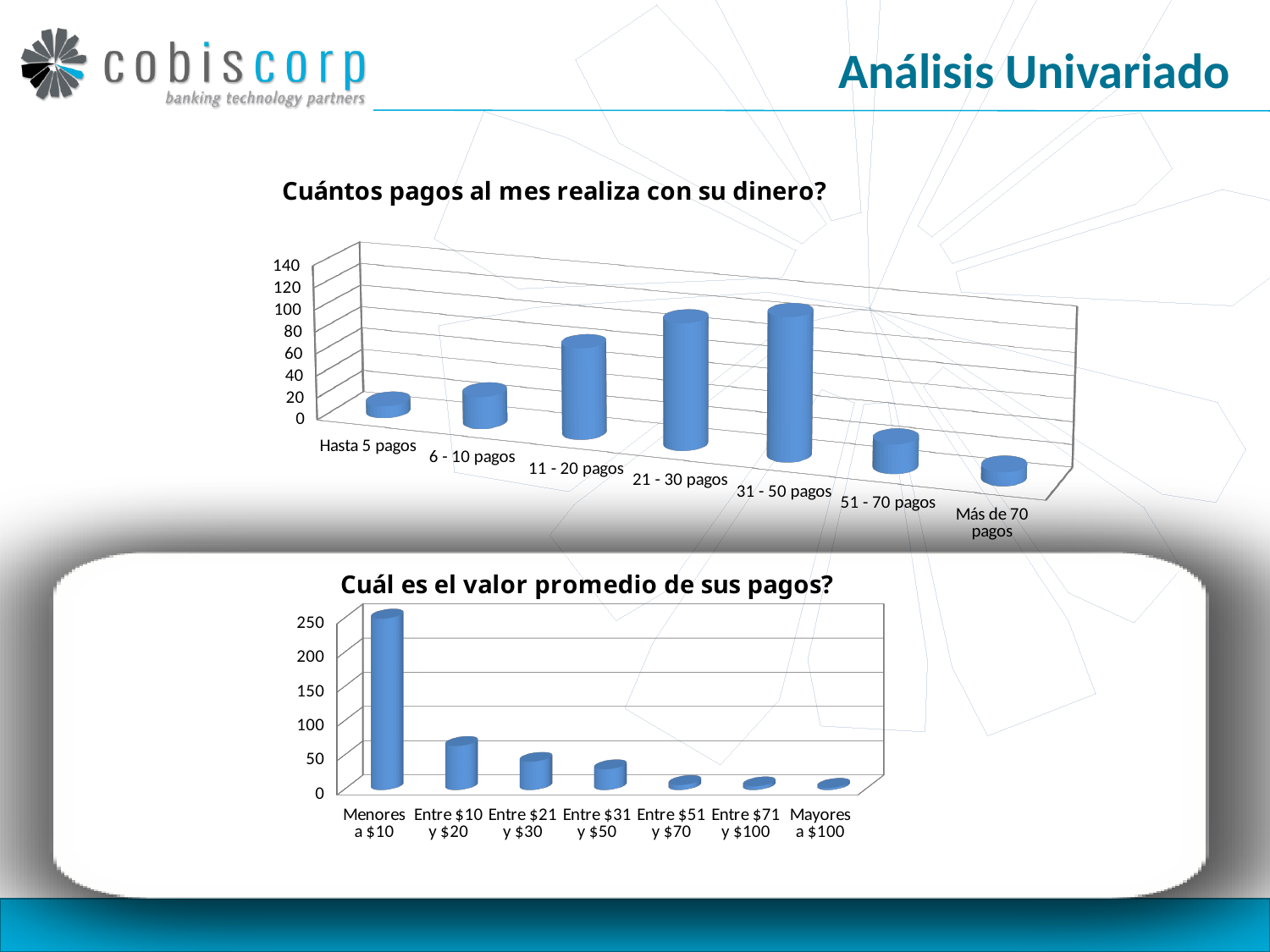
In the bottom chart 'Cuál es el valor promedio de sus pagos?', is the value for 'Menores a $10' greater or less than 200? greater In the top chart 'Cuántos pagos al mes realiza con su dinero?', is the value for 'Hasta 5 pagos' greater or less than 40? less In the top chart 'Cuántos pagos al mes realiza con su dinero?', which category has the highest value? 31 - 50 pagos What type of chart is the top chart titled 'Cuántos pagos al mes realiza con su dinero?'? bar chart In the top chart 'Cuántos pagos al mes realiza con su dinero?', how many categories are shown? 7 In the bottom chart 'Cuál es el valor promedio de sus pagos?', which category has the highest value? Menores a $10 In the bottom chart 'Cuál es el valor promedio de sus pagos?', is the value for 'Entre $10 y $20' greater or less than 100? less In the top chart 'Cuántos pagos al mes realiza con su dinero?', which is larger: '11 - 20 pagos' or '6 - 10 pagos'? 11 - 20 pagos In the bottom chart 'Cuál es el valor promedio de sus pagos?', which is larger: 'Entre $10 y $20' or 'Entre $21 y $30'? Entre $10 y $20 In the bottom chart 'Cuál es el valor promedio de sus pagos?', how many categories are shown? 7 In the bottom chart 'Cuál es el valor promedio de sus pagos?', do the values rise or fall from left to right along the x axis? fall What is the title of the bottom chart on the slide? Cuál es el valor promedio de sus pagos?